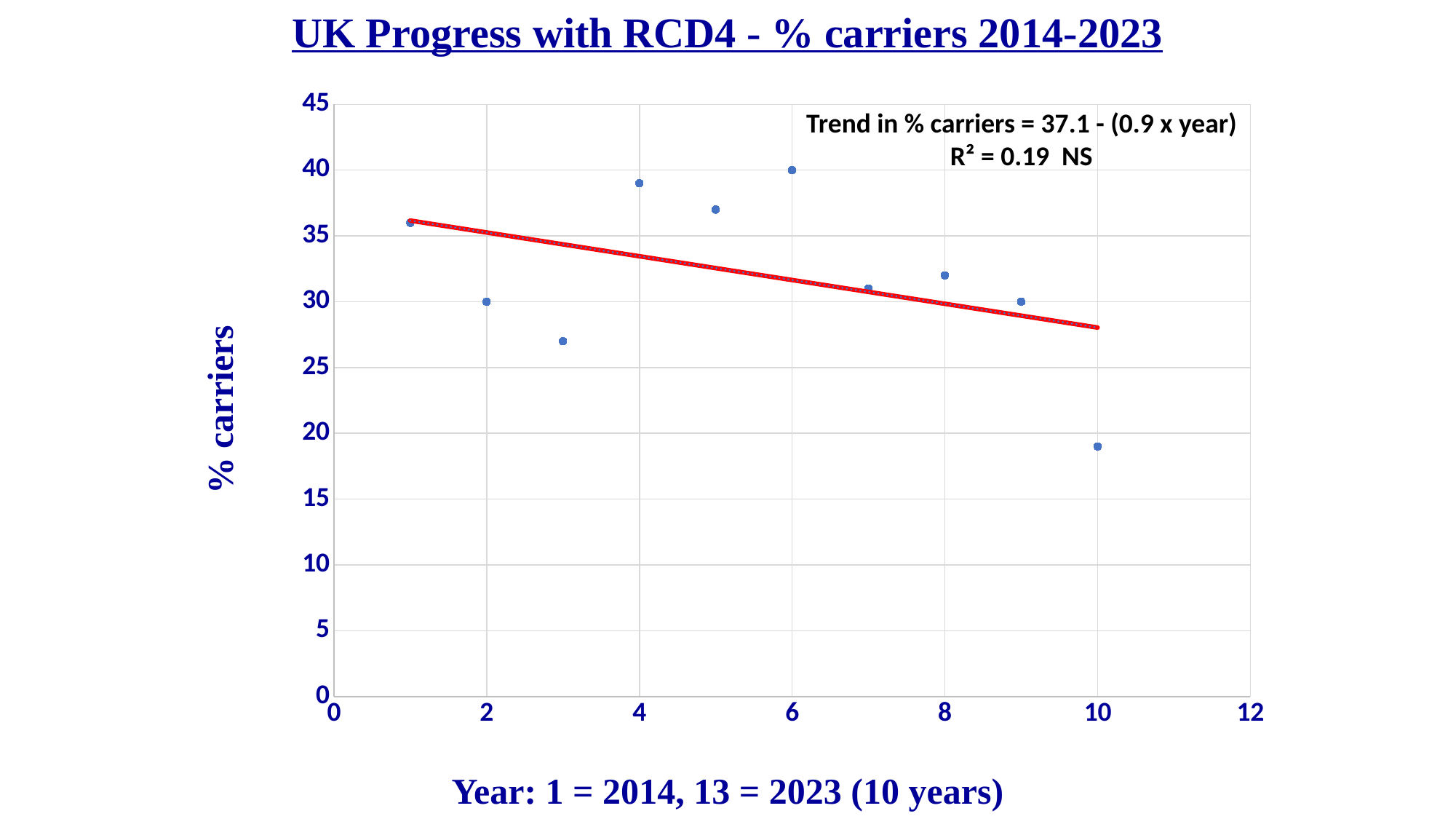
Is the % carriers value for year 3 greater or less than 30? less What kind of chart is shown on the slide? scatter chart What is the % carriers value for year 6? 40 Which year number has the highest % carriers value? 6 Do the % carriers values generally rise or fall along the x axis according to the trend line? fall Is the % carriers value for year 4 greater or less than 35? greater Is the % carriers value for year 10 greater or less than 20? less Which year number has the lowest % carriers value? 10 What R² value is printed on the chart? 0.19 How many data points are plotted on the chart? 10 Which has the larger % carriers value, year 4 or year 2? year 4 What is the trend equation printed on the chart? Trend in % carriers = 37.1 - (0.9 x year)